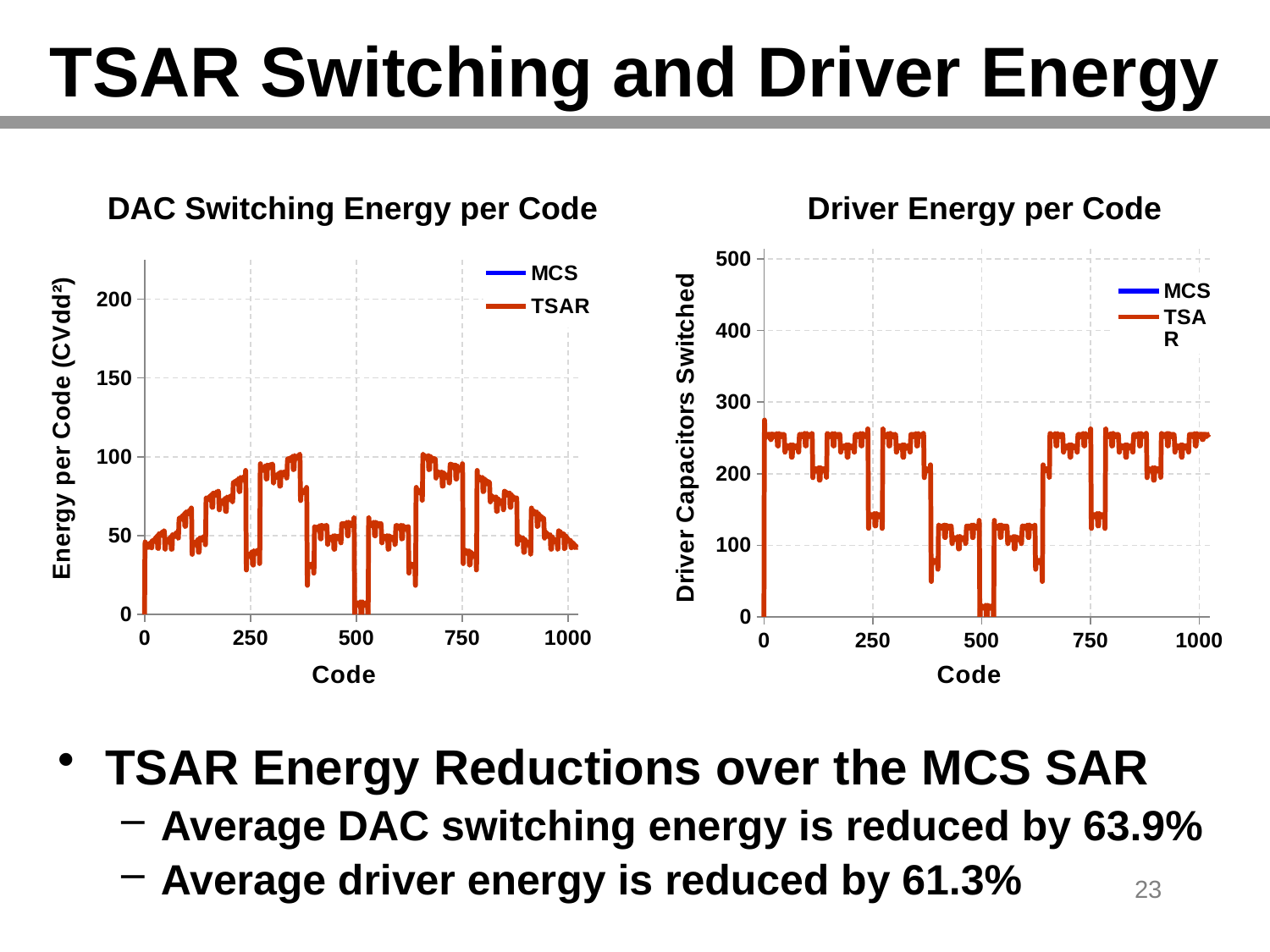
How many series does the legend of the 'DAC Switching Energy per Code' chart list? 2 What kind of chart is the 'DAC Switching Energy per Code' chart? line chart In the 'Driver Energy per Code' chart, is the TSAR value at code 100 greater or less than 200? greater What kind of chart is the 'Driver Energy per Code' chart? line chart In the 'DAC Switching Energy per Code' chart, is the TSAR value at code 1000 greater or less than 100? less In the 'DAC Switching Energy per Code' chart, what is the y-axis title? Energy per Code (CVdd²) In the 'DAC Switching Energy per Code' chart, is the TSAR value at code 500 greater or less than 50? less In the 'Driver Energy per Code' chart, what is the y-axis title? Driver Capacitors Switched How many series does the legend of the 'Driver Energy per Code' chart list? 2